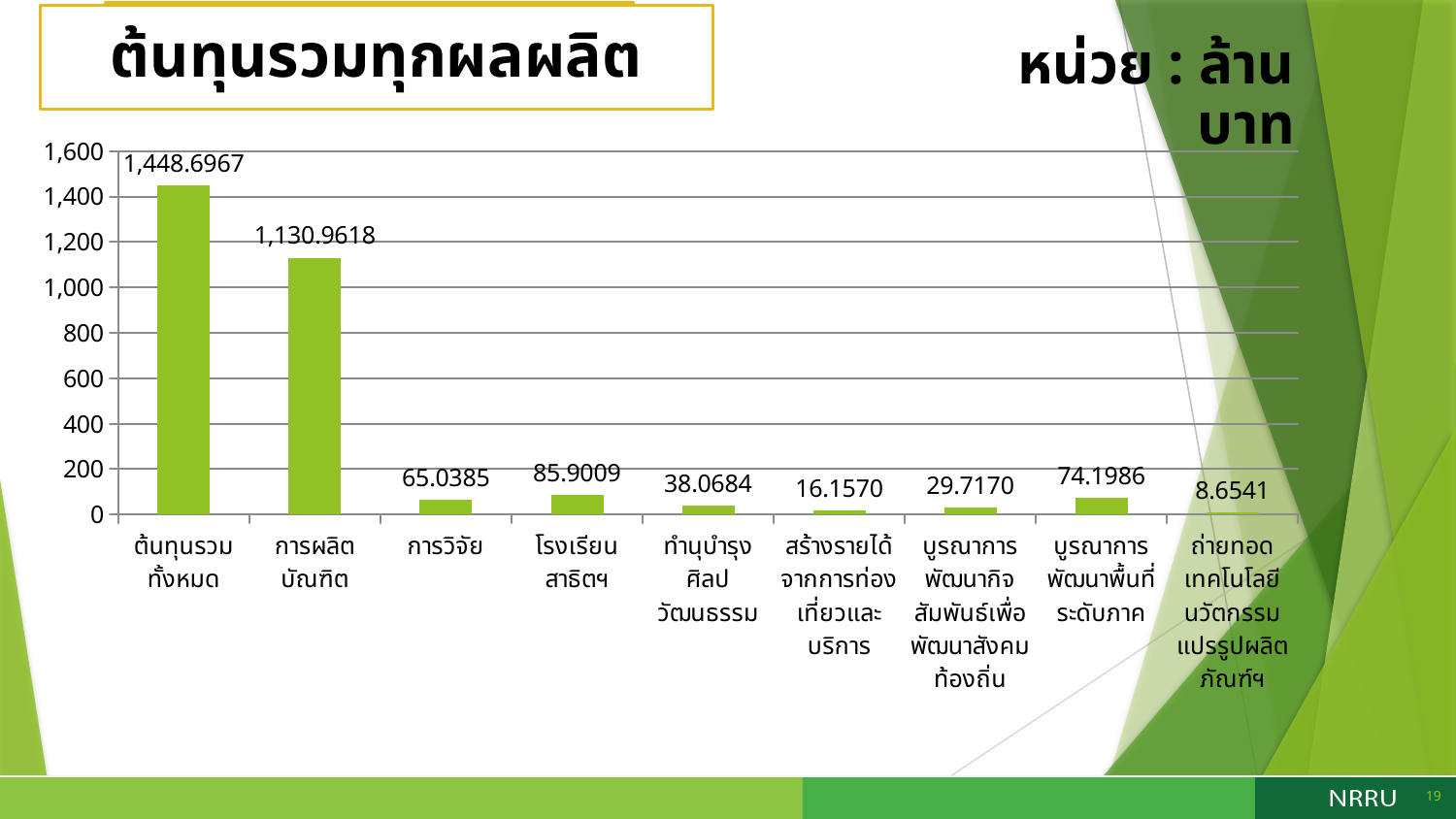
Which category has the lowest value? ถ่ายทอดเทคโนโลยีนวัตกรรมแปรรูปผลิตภัณฑ์ฯ What kind of chart is shown on the slide? bar chart Which is larger, โรงเรียนสาธิตฯ or บูรณาการพัฒนาพื้นที่ระดับภาค? โรงเรียนสาธิตฯ Is the value for การผลิตบัณฑิต greater or less than 1,000? greater What is the value for โรงเรียนสาธิตฯ? 85.9009 What is the value for สร้างรายได้จากการท่องเที่ยวและบริการ? 16.1570 What is the value for การวิจัย? 65.0385 What is the value for การผลิตบัณฑิต? 1,130.9618 Which category has the highest value? ต้นทุนรวมทั้งหมด What is the difference between ต้นทุนรวมทั้งหมด and การผลิตบัณฑิต? 317.7349 What unit is stated for the values on the slide? ล้านบาท How many categories are shown on the x axis? 9